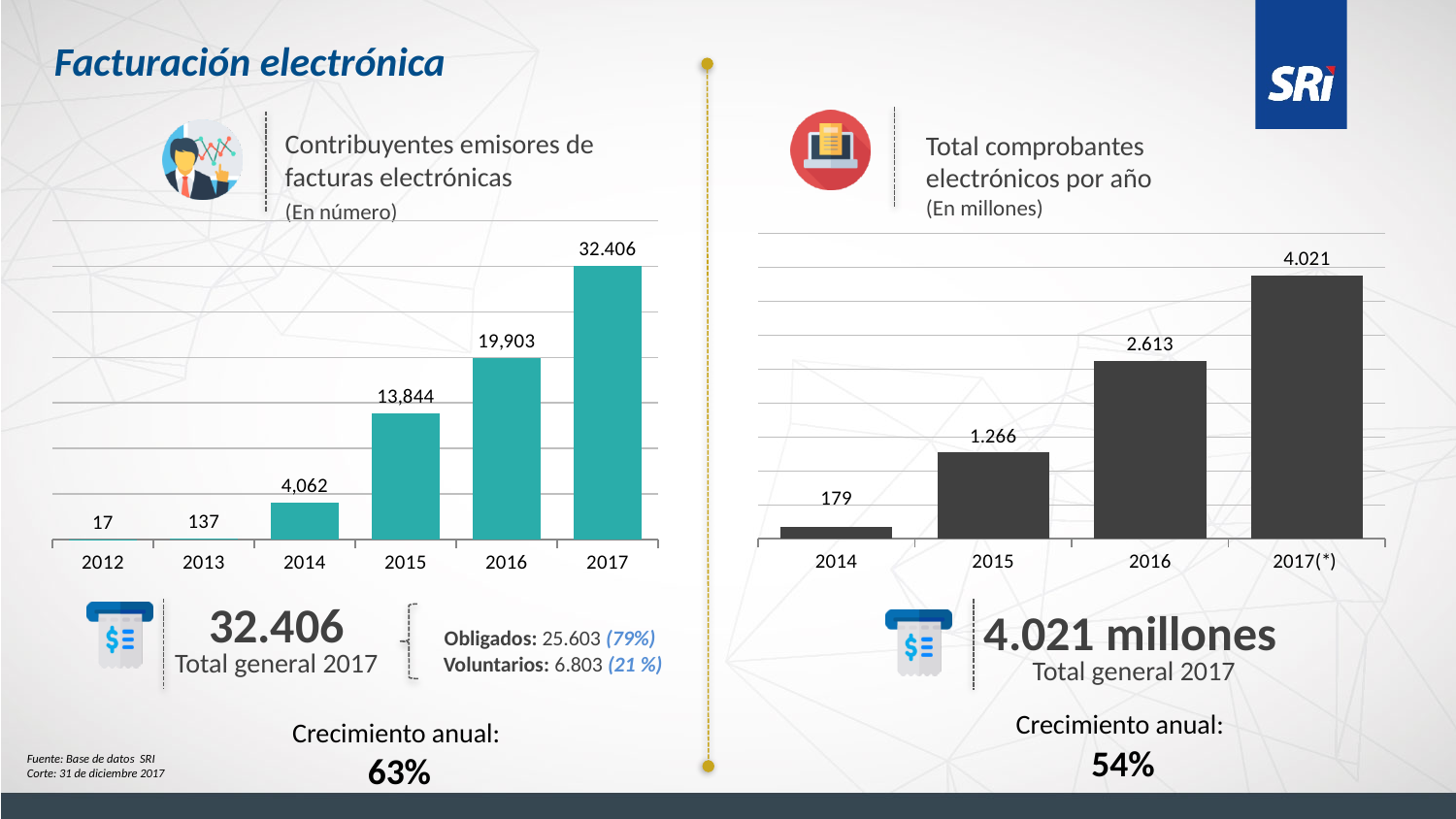
In the chart 'Total comprobantes electrónicos por año', how many years are shown on the x axis? 4 In the chart 'Contribuyentes emisores de facturas electrónicas', do the values rise or fall from 2012 to 2017? rise What type of chart is 'Total comprobantes electrónicos por año'? bar chart In the chart 'Contribuyentes emisores de facturas electrónicas', how many years are shown on the x axis? 6 In the chart 'Contribuyentes emisores de facturas electrónicas', which year has the lowest value? 2012 In the chart 'Contribuyentes emisores de facturas electrónicas', which year has the highest value? 2017 In the chart 'Total comprobantes electrónicos por año', what is the difference between the values for 2017(*) and 2016? 1.408 In the chart 'Contribuyentes emisores de facturas electrónicas', what is the value for 2012? 17 In the chart 'Total comprobantes electrónicos por año', which is larger, the value for 2015 or the value for 2016? 2016 In the chart 'Total comprobantes electrónicos por año', what is the value for 2016? 2.613 In the chart 'Contribuyentes emisores de facturas electrónicas', what is the value for 2015? 13,844 In the chart 'Total comprobantes electrónicos por año', what is the value for 2014? 179